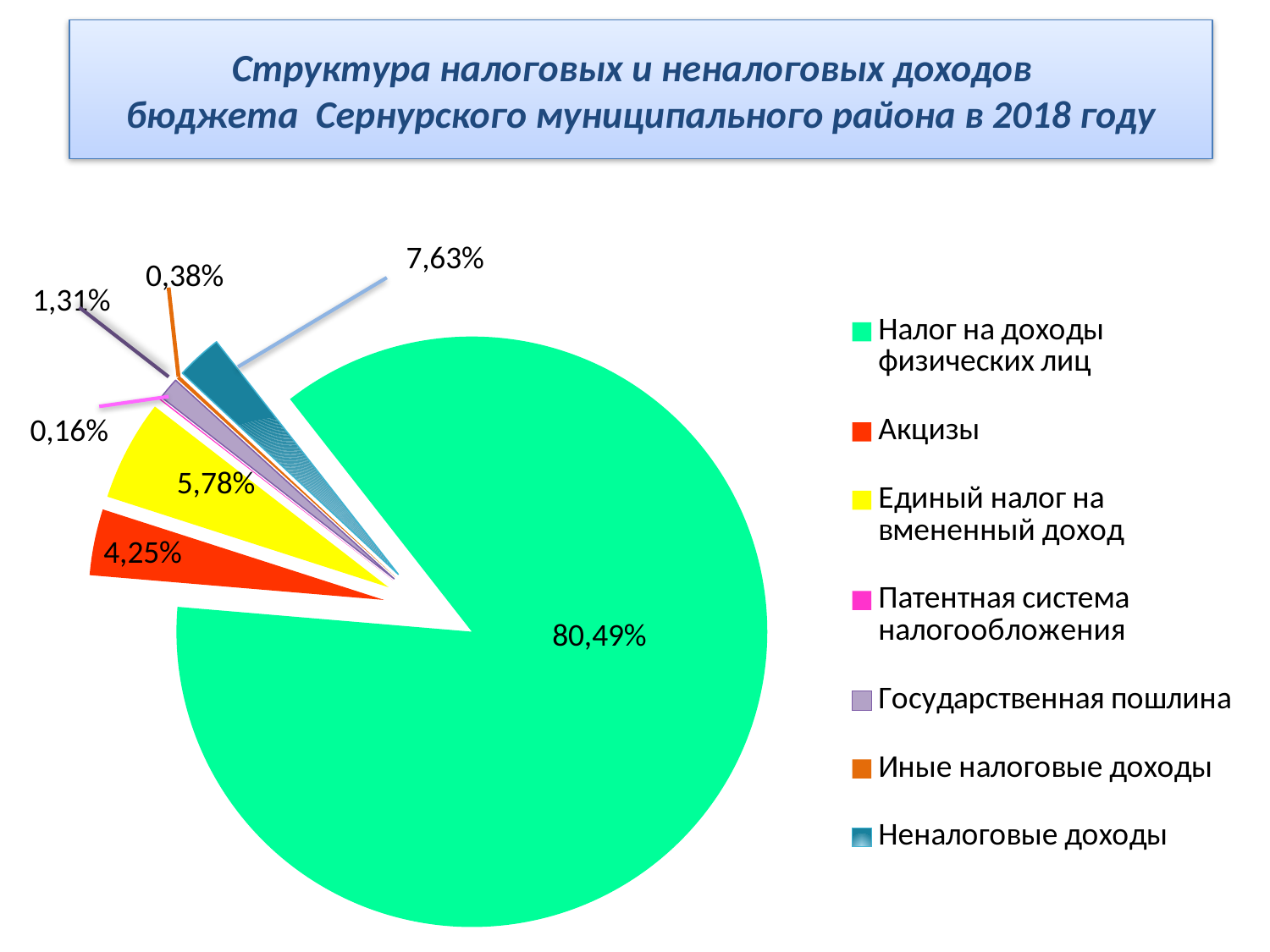
What is the value shown for Акцизы? 4,25% How many categories does the legend list? 7 What is the value shown for Единый налог на вмененный доход? 5,78% What share of the pie does Налог на доходы физических лиц have? 80,49% What is the value shown for Неналоговые доходы? 7,63% What is the difference between the shares of Неналоговые доходы and Акцизы? 3,38% Which category has the smallest slice of the pie? Патентная система налогообложения Which category has the largest slice of the pie? Налог на доходы физических лиц What is the value shown for Государственная пошлина? 1,31% What colour is the slice for Иные налоговые доходы? Orange What type of chart is shown on the slide? Pie chart Which is larger, Акцизы or Единый налог на вмененный доход? Единый налог на вмененный доход